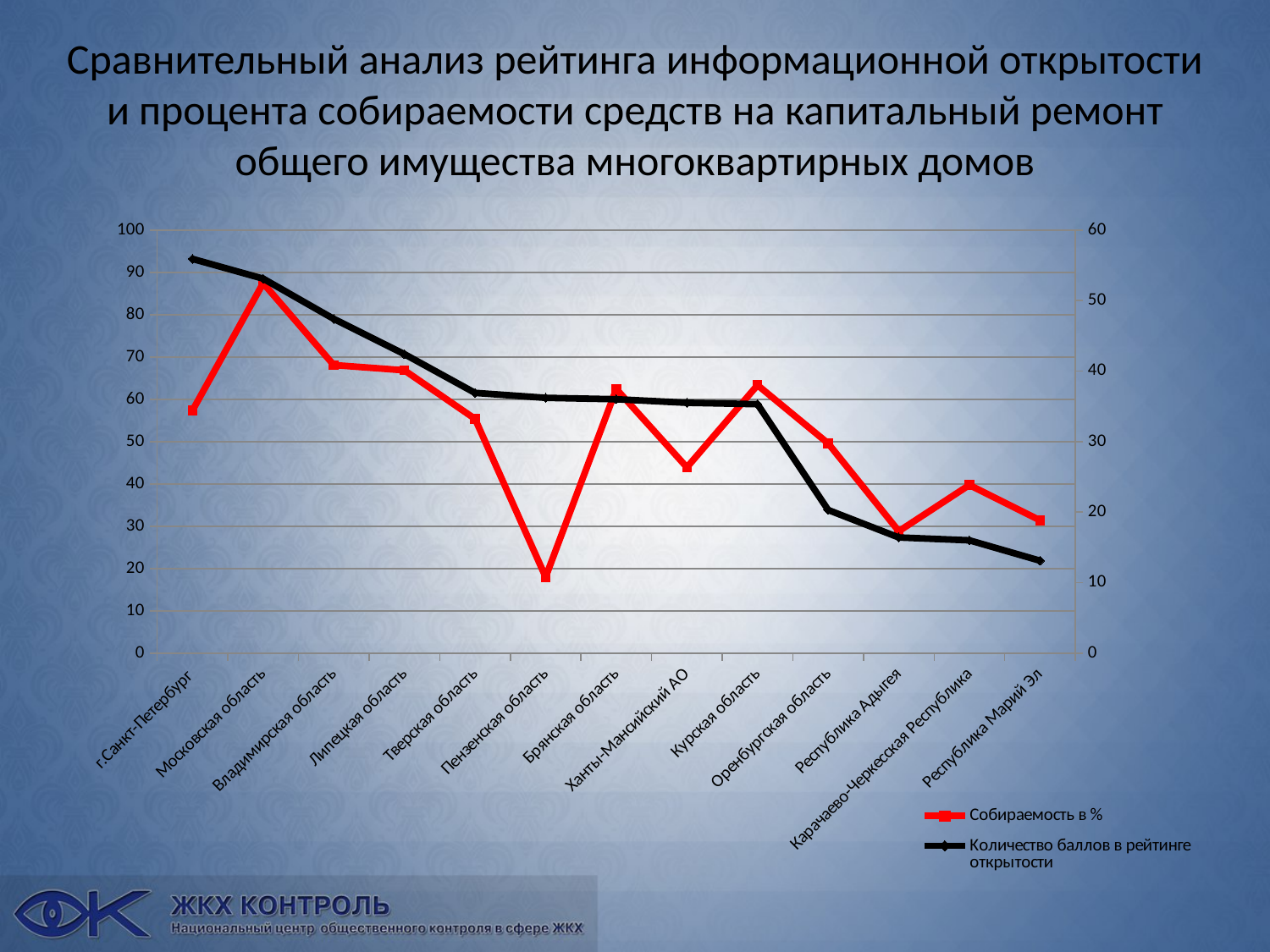
Is the Собираемость в % value for Московская область greater or less than 80? greater How many regions are plotted along the x axis? 13 How many series does the legend list? 2 What colour is the line for Собираемость в %? red Which region has the highest value for Собираемость в %? Московская область What kind of chart is shown on the slide? line chart Which region has the lowest value for Количество баллов в рейтинге открытости? Республика Марий Эл Is the Собираемость в % value for Пензенская область greater or less than 30? less Which has the larger Собираемость в % value, Брянская область or Ханты-Мансийский АО? Брянская область Which region has the highest value for Количество баллов в рейтинге открытости? г.Санкт-Петербург Which region has the lowest value for Собираемость в %? Пензенская область Does the Количество баллов в рейтинге открытости line generally rise or fall from left to right? fall